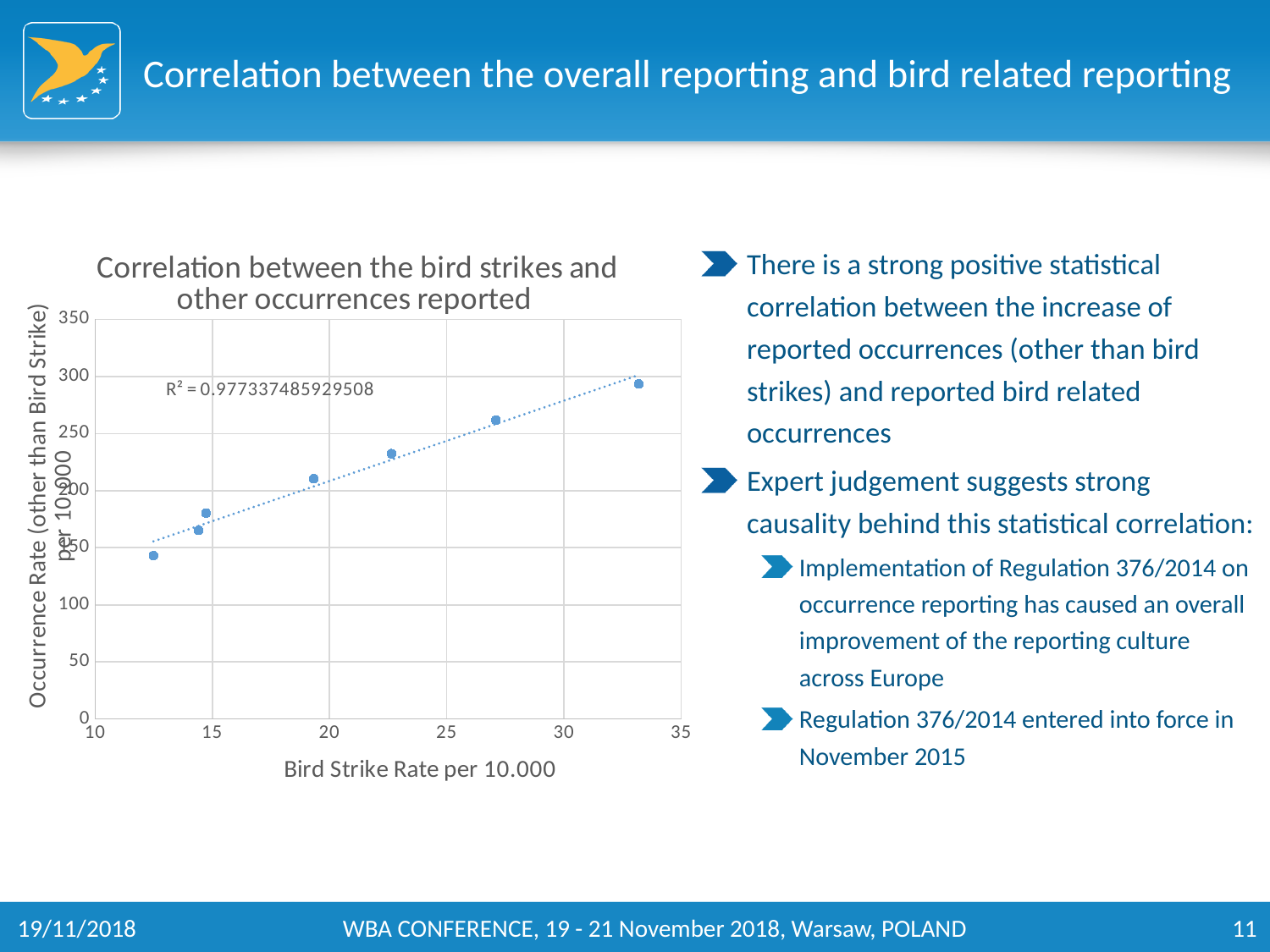
Do the occurrence rate values rise or fall as the bird strike rate increases along the x axis? Rise What is the label of the x axis of the chart? Bird Strike Rate per 10.000 What is the title of the chart? Correlation between the bird strikes and other occurrences reported What is the R² value printed on the chart? R² = 0.977337485929508 Is the occurrence rate for the point with the lowest bird strike rate (around 12.5) greater or less than 200? less What kind of chart is shown on the slide? Scatter chart Is the occurrence rate for the point at a bird strike rate of about 19 greater or less than 150? greater Is the occurrence rate for the point at a bird strike rate of about 27 greater or less than 200? greater How many data points are plotted in the scatter chart? 7 Which point has the higher occurrence rate: the one at a bird strike rate of about 22.5 or the one at about 14.5? The one at about 22.5